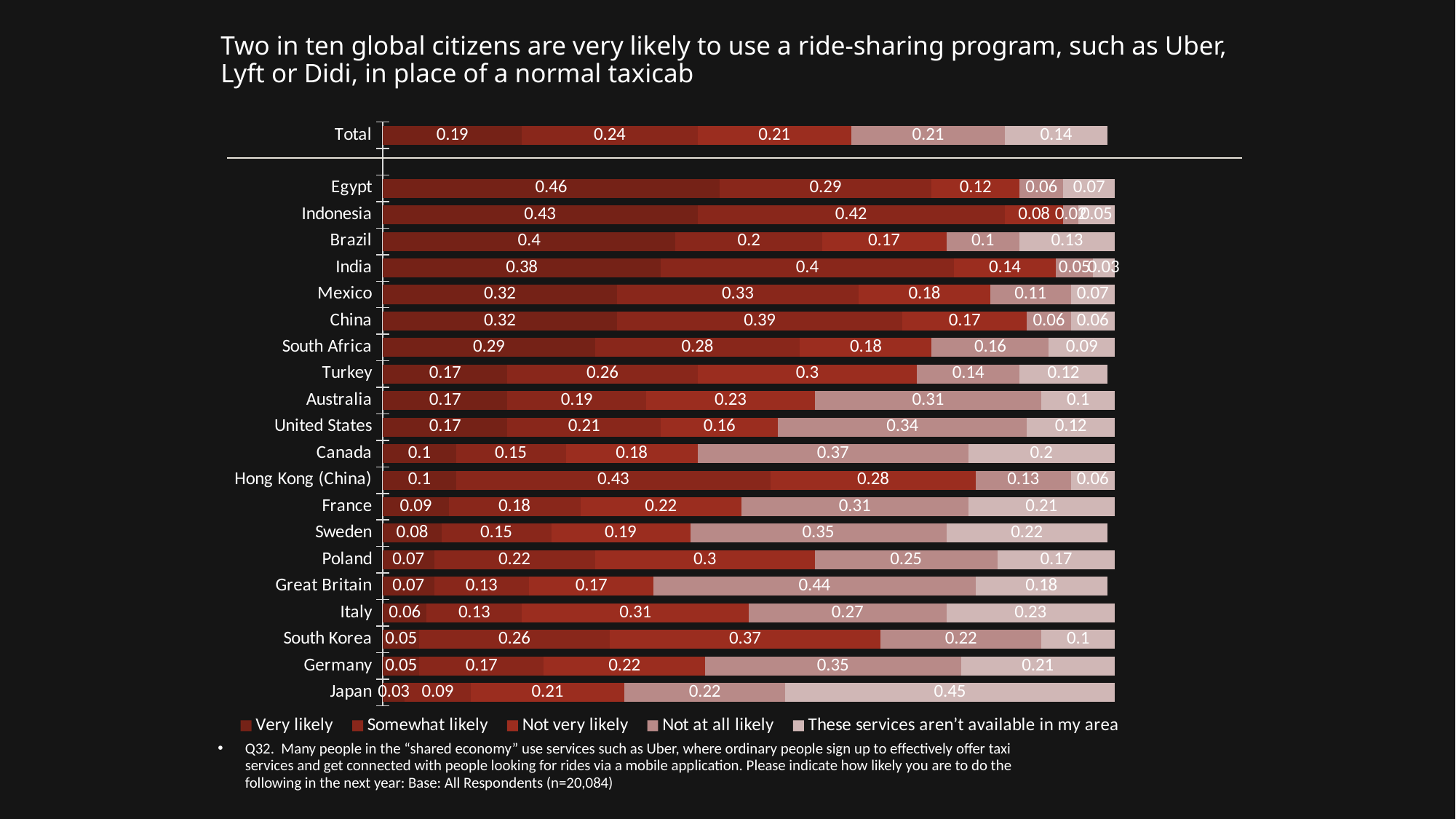
What is the 'These services aren't available in my area' value for Japan? 0.45 Which has the larger 'Not at all likely' value, Australia or the United States? United States What kind of chart is shown on the slide? Stacked bar chart How many series does the legend list? 5 How many bars (rows) are plotted in the chart, including Total? 21 Which country has the lowest 'Very likely' value? Japan What is the 'Not at all likely' value for Canada? 0.37 Which country has the highest 'Very likely' value? Egypt What is the difference between the 'Not at all likely' values for Great Britain and Canada? 0.07 What is the 'Very likely' value for Egypt? 0.46 What is the total of the stacked bar for Canada? 1 What is the 'Somewhat likely' value for the Total row? 0.24